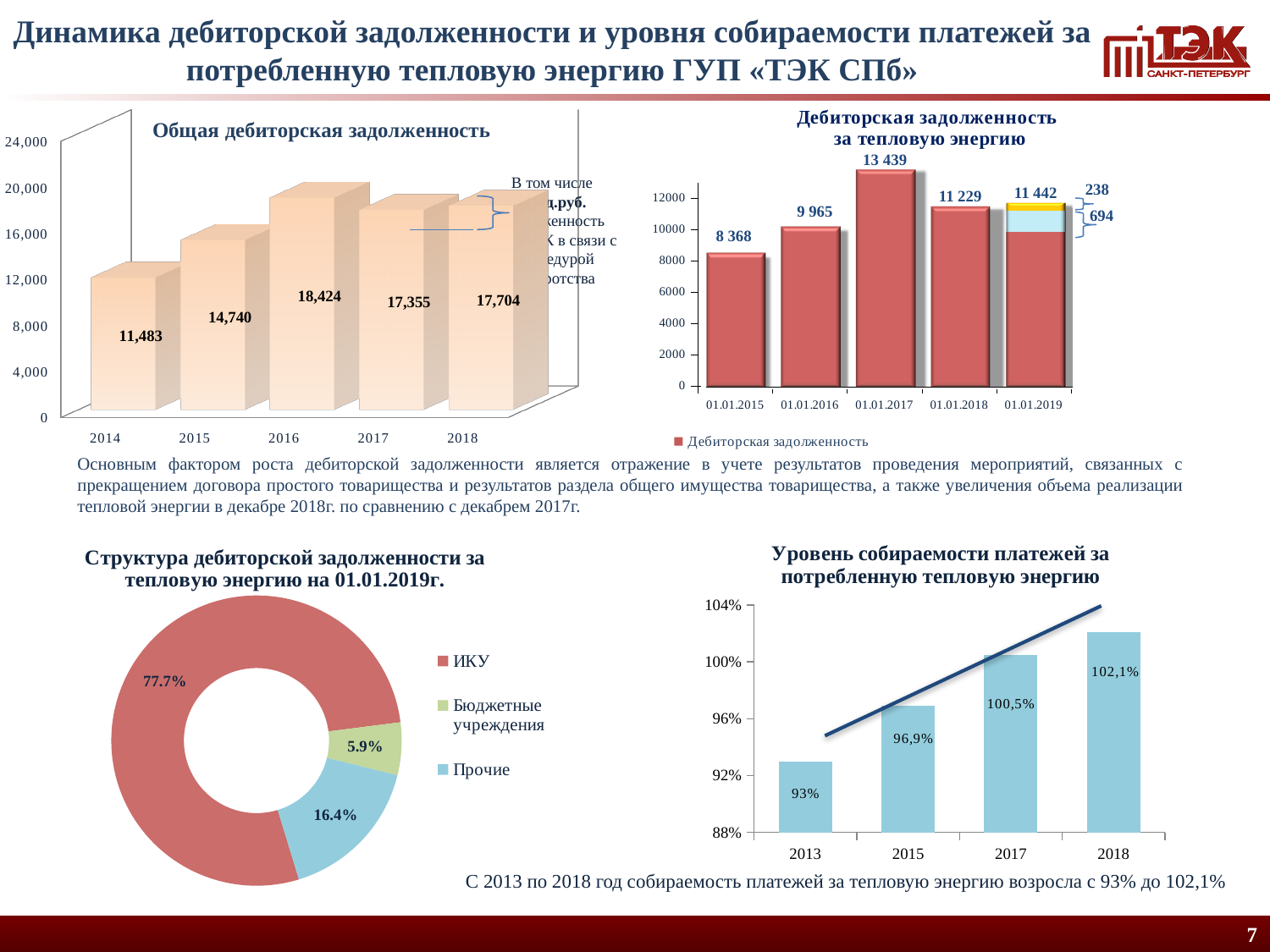
In the chart 'Уровень собираемости платежей за потребленную тепловую энергию', what is the value for 2017? 100,5% In the chart 'Дебиторская задолженность за тепловую энергию', which date has the highest value? 01.01.2017 In the chart 'Общая дебиторская задолженность', what is the difference between the values for 2016 and 2017? 1,069 In the chart 'Общая дебиторская задолженность', how many years are shown on the x axis? 5 In the chart 'Дебиторская задолженность за тепловую энергию', which is larger: the value for 01.01.2018 or 01.01.2019? 01.01.2019 In the chart 'Общая дебиторская задолженность', what is the value for 2016? 18,424 In the chart 'Дебиторская задолженность за тепловую энергию', what is the difference between the values for 01.01.2016 and 01.01.2015? 1 597 In the chart 'Структура дебиторской задолженности за тепловую энергию на 01.01.2019г.', which category has the largest share? ИКУ In the chart 'Дебиторская задолженность за тепловую энергию', what is the value for 01.01.2017? 13 439 In the chart 'Общая дебиторская задолженность', which year has the lowest value? 2014 In the chart 'Уровень собираемости платежей за потребленную тепловую энергию', do the values rise or fall from 2013 to 2018? rise In the chart 'Структура дебиторской задолженности за тепловую энергию на 01.01.2019г.', what share does 'Прочие' have? 16.4%